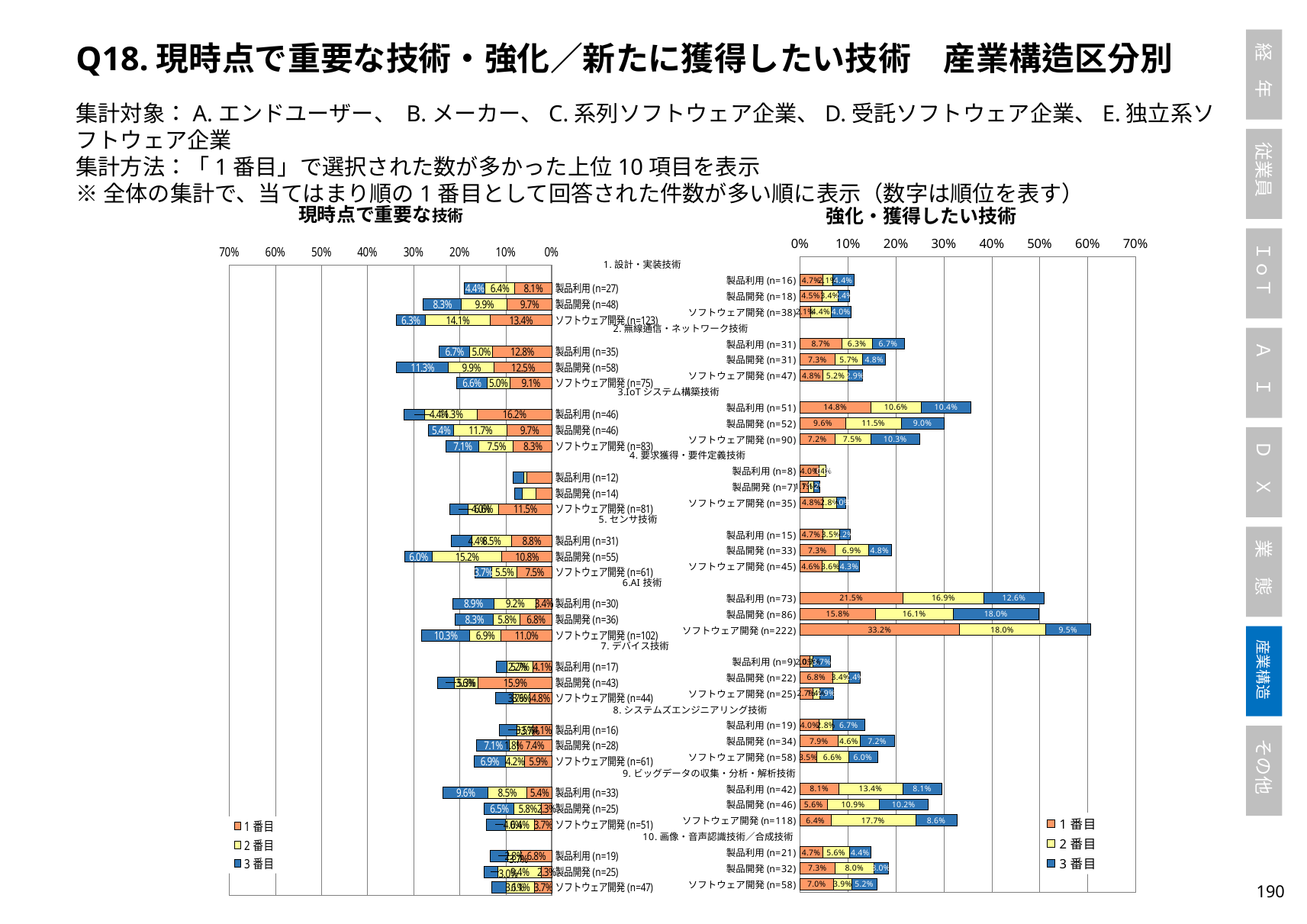
In the left chart (現時点で重要な技術), what is the 2番目 value for ソフトウェア開発 (n=123) under 1.設計・実装技術? 14.1% In the right chart (強化・獲得したい技術), what is the total of the stacked bar for ソフトウェア開発 (n=222) under 6.AI技術? 60.7% In the right chart (強化・獲得したい技術), what is the 1番目 value for ソフトウェア開発 (n=222) under 6.AI技術? 33.2% How many series does the legend of the right chart (強化・獲得したい技術) list? 3 In the left chart (現時点で重要な技術), what is the 1番目 value for 製品開発 (n=58) under 2.無線通信・ネットワーク技術? 12.5% In the left chart (現時点で重要な技術), which is larger for ソフトウェア開発 (n=102) under 6.AI技術: the 1番目 value or the 2番目 value? 1番目 (11.0%) In the right chart (強化・獲得したい技術), which respondent group under 6.AI技術 has the longest stacked bar? ソフトウェア開発 (n=222) In the right chart (強化・獲得したい技術), is the 1番目 value for 製品利用 (n=51) under 3.IoTシステム構築技術 greater or less than 10%? greater In the right chart (強化・獲得したい技術), what is the 2番目 value for ソフトウェア開発 (n=118) under 9.ビッグデータの収集・分析・解析技術? 17.7% What kind of chart is the left chart (現時点で重要な技術)? Stacked horizontal bar chart In the right chart (強化・獲得したい技術), what is the 3番目 value for 製品利用 (n=73) under 6.AI技術? 12.6% In the left chart (現時点で重要な技術), what is the difference between the 2番目 value (15.2%) and the 3番目 value (6.0%) for 製品開発 (n=55) under 5.センサ技術? 9.2%